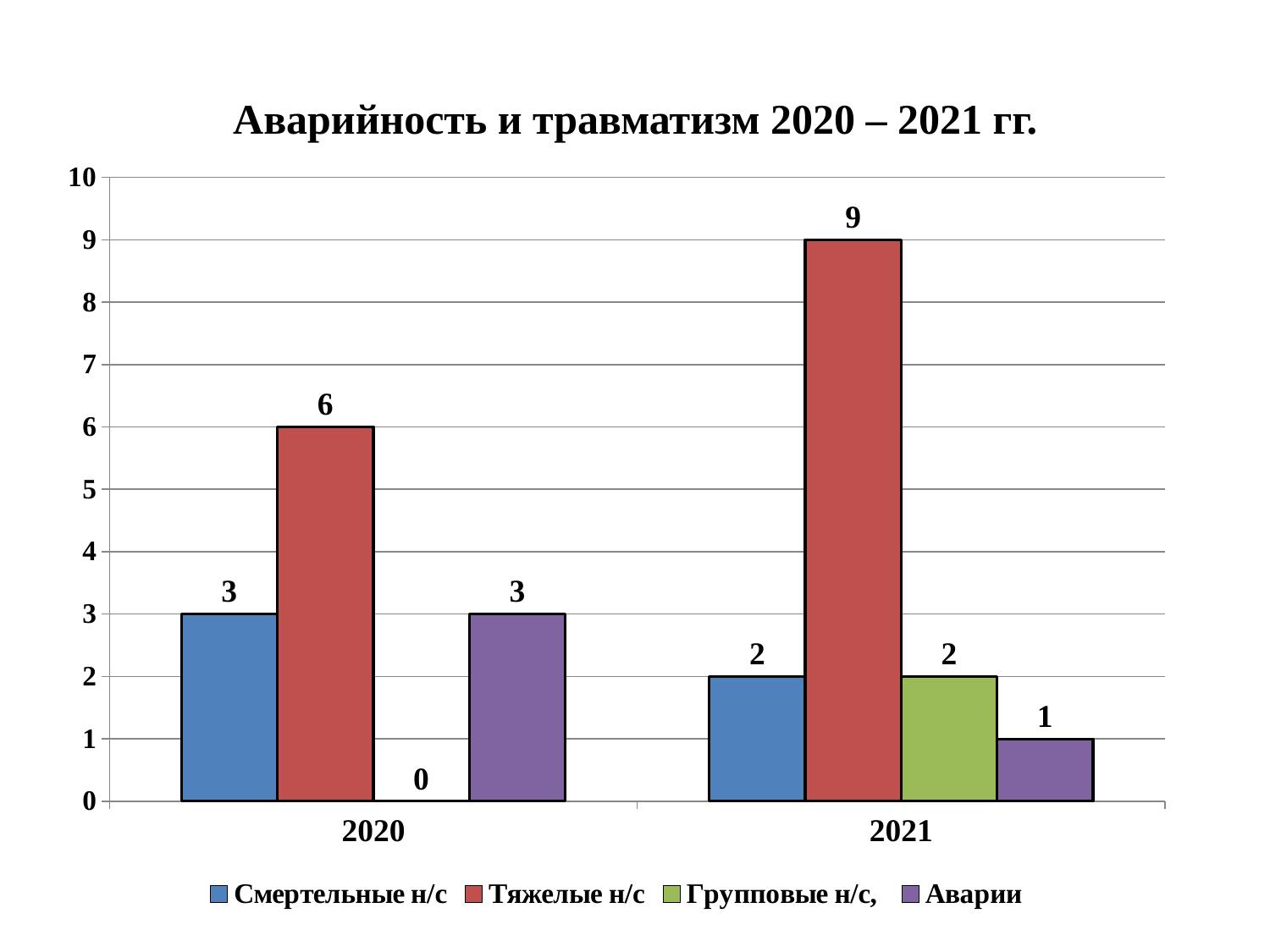
How many categories are shown on the x axis? 2 What is the value for Смертельные н/с in 2020? 3 What is the value for Аварии in 2021? 1 What kind of chart is shown on the slide? Bar chart What is the title of the chart? Аварийность и травматизм 2020 – 2021 гг. Which series has the highest value in 2020? Тяжелые н/с Which series has the lowest value in 2021? Аварии What is the difference between Тяжелые н/с in 2021 and Тяжелые н/с in 2020? 3 How many series does the legend list? 4 What is the value for Групповые н/с in 2020? 0 Which is larger: Аварии in 2020 or Аварии in 2021? Аварии in 2020 What is the value for Тяжелые н/с in 2021? 9